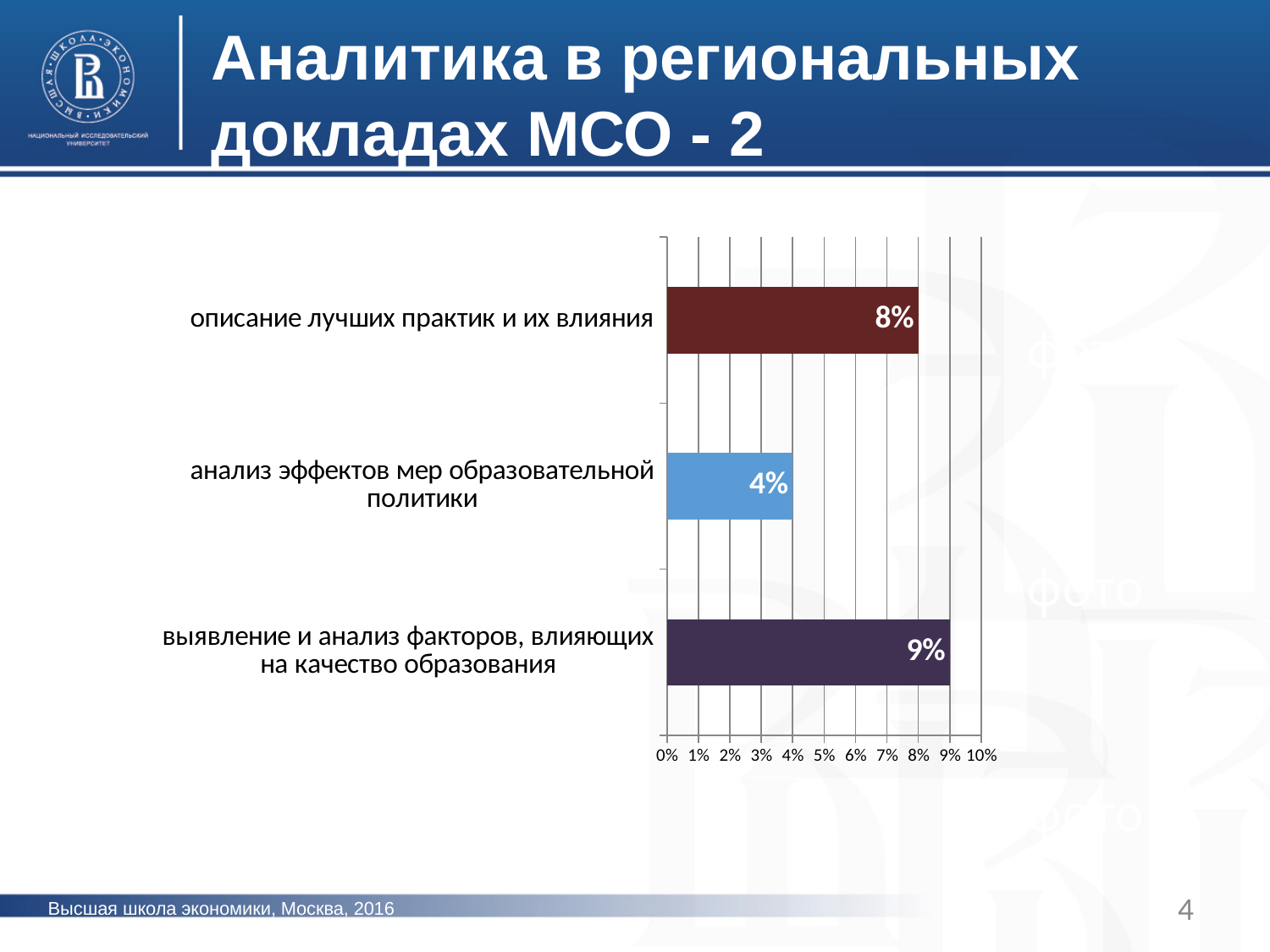
What is the difference between the values for "выявление и анализ факторов, влияющих на качество образования" and "анализ эффектов мер образовательной политики"? 5% What is the value for "описание лучших практик и их влияния"? 8% Which category has the highest value? выявление и анализ факторов, влияющих на качество образования What kind of chart is shown on the slide? bar chart What is the value for "выявление и анализ факторов, влияющих на качество образования"? 9% How many categories are shown in the chart? 3 Which is larger: the value for "описание лучших практик и их влияния" or for "анализ эффектов мер образовательной политики"? описание лучших практик и их влияния Which category has the lowest value? анализ эффектов мер образовательной политики What is the value for "анализ эффектов мер образовательной политики"? 4% What is the difference between the values for "описание лучших практик и их влияния" and "анализ эффектов мер образовательной политики"? 4% What is the maximum value shown on the horizontal axis? 10% Is the value for "анализ эффектов мер образовательной политики" greater or less than 5%? less